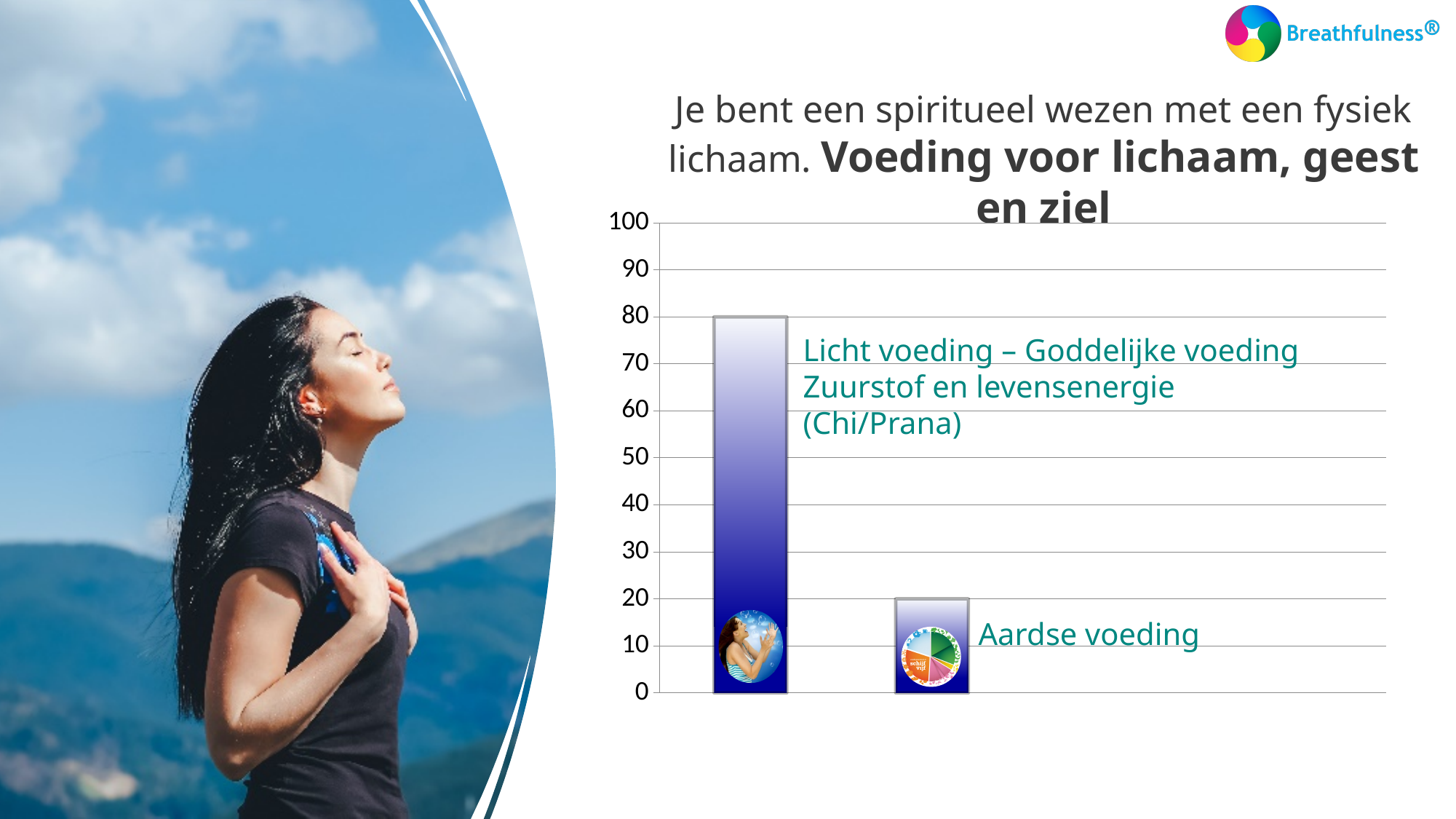
What value does the bar labelled "Aardse voeding" reach on the axis? 20 How many bars does the chart show? 2 What is the difference between the "Licht voeding – Goddelijke voeding" bar and the "Aardse voeding" bar? 60 Is the value for "Licht voeding – Goddelijke voeding" greater or less than 50? greater Which bar is the lowest? Aardse voeding Do the bar values rise or fall from left to right? fall What value does the bar labelled "Licht voeding – Goddelijke voeding" reach on the axis? 80 What type of chart is shown on the slide? bar chart Which bar is the highest? Licht voeding – Goddelijke voeding Is the value for "Aardse voeding" greater or less than 50? less What is the maximum value shown on the vertical axis? 100 Which is larger, the bar for "Licht voeding – Goddelijke voeding" or the bar for "Aardse voeding"? Licht voeding – Goddelijke voeding